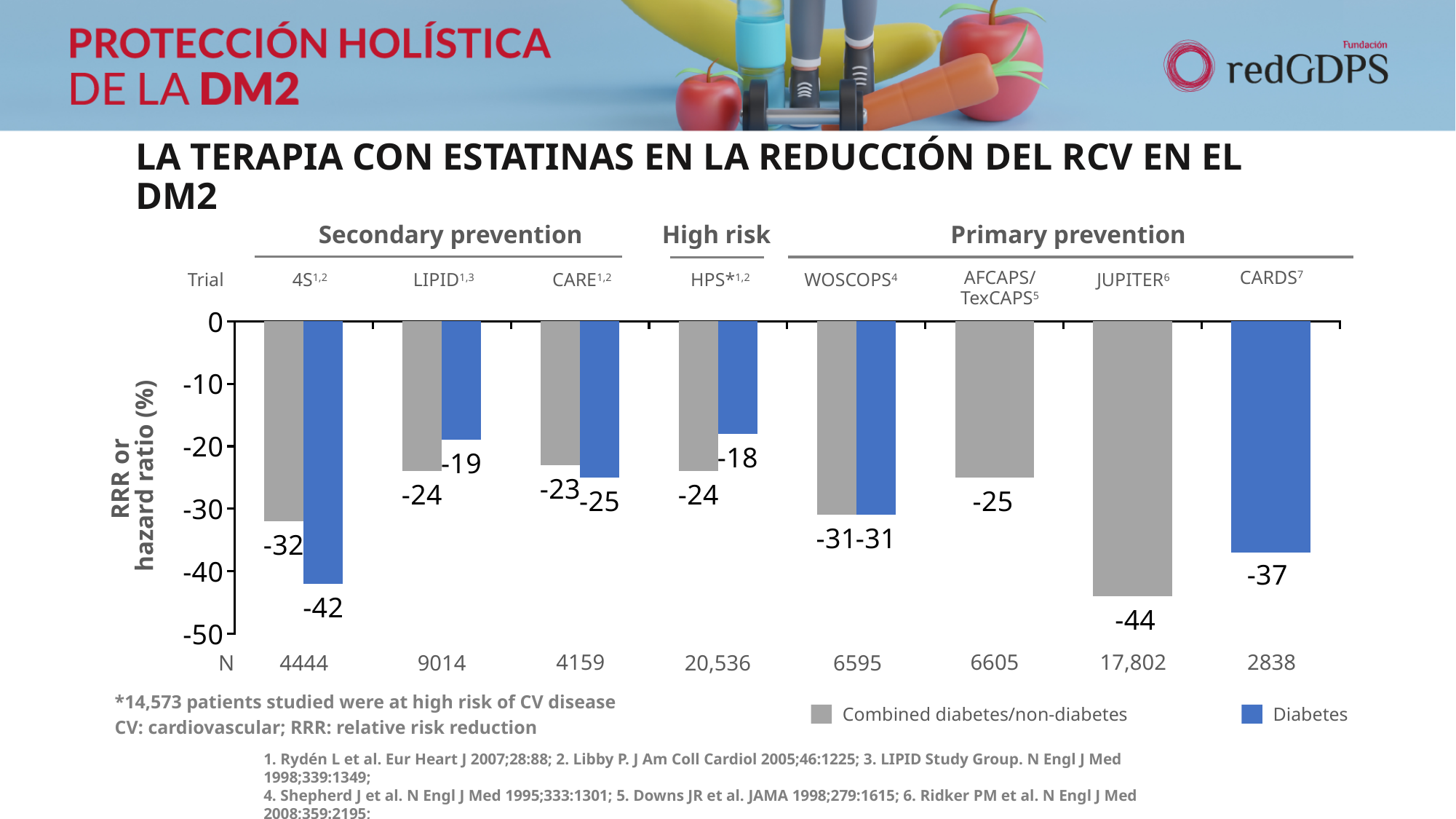
How many series does the chart legend list? 2 How many trials are shown on the x axis of the chart? 8 What kind of chart is shown on the slide? Bar chart Which trial has the lowest (most negative) Combined diabetes/non-diabetes value? JUPITER What is the Combined diabetes/non-diabetes value for the JUPITER trial? -44 What is the difference between the Combined diabetes/non-diabetes value and the Diabetes value for the 4S trial? 10 What is the Diabetes value for the CARDS trial? -37 Which is more negative for the LIPID trial, the Combined diabetes/non-diabetes value or the Diabetes value? Combined diabetes/non-diabetes What is the Combined diabetes/non-diabetes value for the HPS trial? -24 What is the Diabetes value for the 4S trial? -42 Which trial has the lowest (most negative) Diabetes value? 4S What is the N value shown for the HPS trial? 20,536